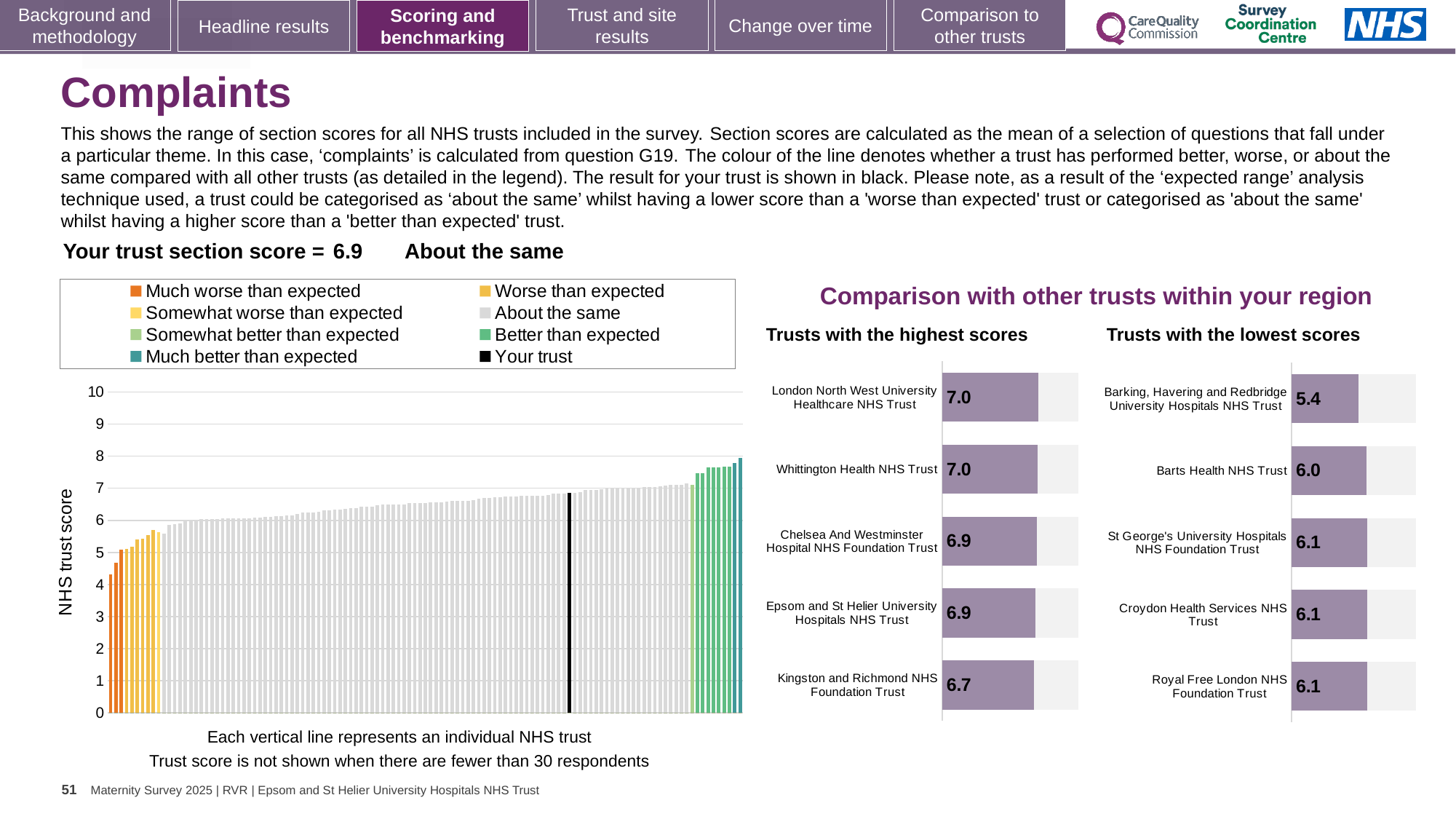
How many entries does the legend of the NHS trust score chart on the left list? 8 In the 'Trusts with the lowest scores' chart, what is the score for Barking, Havering and Redbridge University Hospitals NHS Trust? 5.4 In the 'Trusts with the highest scores' chart, what is the score for Kingston and Richmond NHS Foundation Trust? 6.7 In the 'Trusts with the lowest scores' chart, which has the higher score: Barts Health NHS Trust or Barking, Havering and Redbridge University Hospitals NHS Trust? Barts Health NHS Trust In the 'Trusts with the highest scores' chart, what is the score for Whittington Health NHS Trust? 7.0 What kind of chart is the NHS trust score chart on the left of the slide? Bar chart In the 'Trusts with the lowest scores' chart, what is the difference between the scores of Barts Health NHS Trust and Barking, Havering and Redbridge University Hospitals NHS Trust? 0.6 In the 'Trusts with the highest scores' chart, what is the difference between the scores of London North West University Healthcare NHS Trust and Kingston and Richmond NHS Foundation Trust? 0.3 How many trusts are listed in the 'Trusts with the highest scores' chart? 5 In the 'Trusts with the highest scores' chart, which trust has the lowest score? Kingston and Richmond NHS Foundation Trust In the 'Trusts with the lowest scores' chart, what is the score for Barts Health NHS Trust? 6.0 In the 'Trusts with the lowest scores' chart, which trust has the lowest score? Barking, Havering and Redbridge University Hospitals NHS Trust